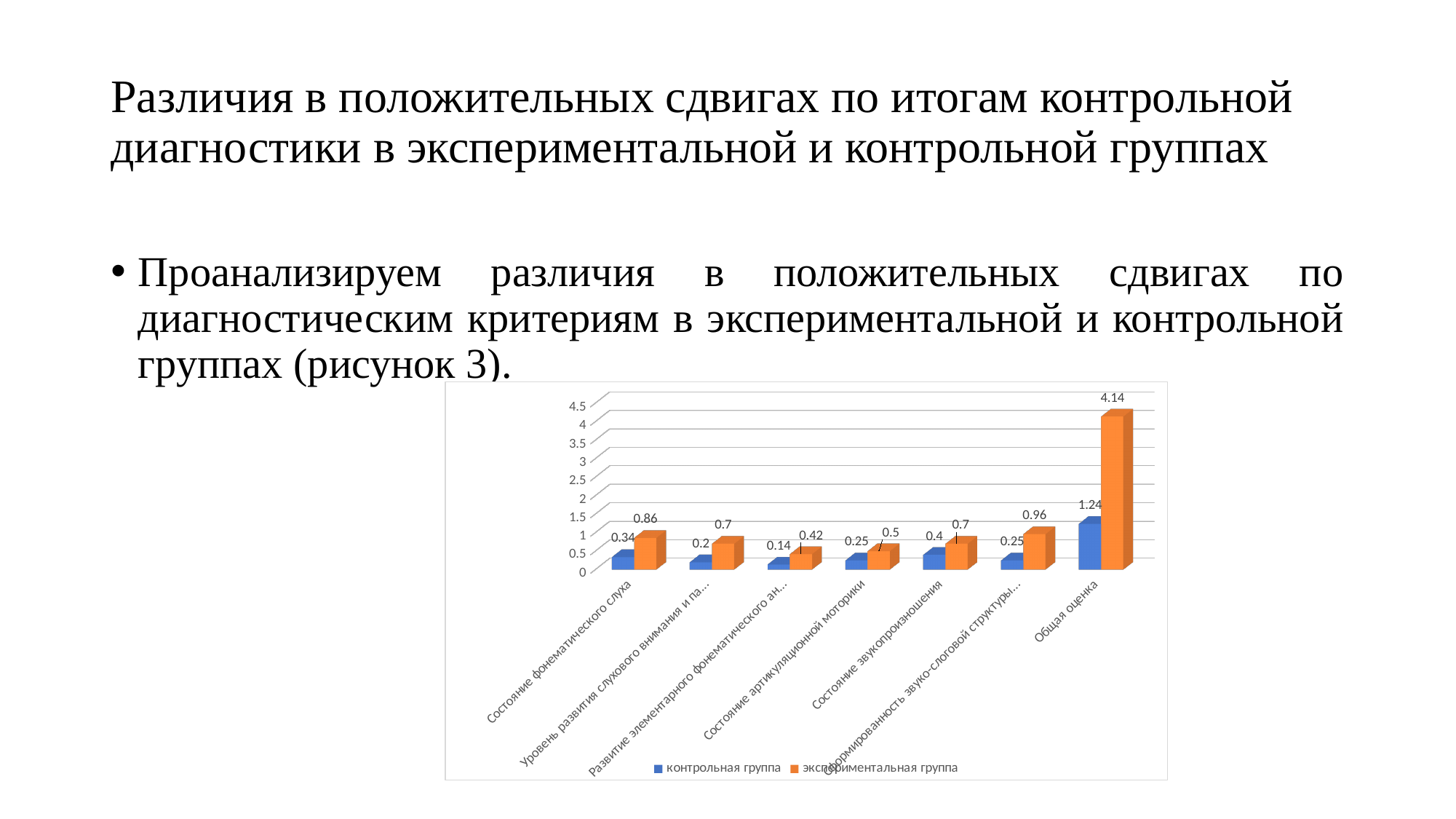
Which category has the highest value for the экспериментальная группа series? Общая оценка What is the value for the контрольная группа series for Состояние фонематического слуха? 0.34 How many categories are shown on the x axis of the chart? 7 How many series does the chart legend list? 2 Which category has the lowest value for the контрольная группа series? Развитие элементарного фонематического ан... What is the value for the экспериментальная группа series for Общая оценка? 4.14 What kind of chart is shown on the slide? bar chart For Состояние фонематического слуха, which series has the larger value: контрольная группа or экспериментальная группа? экспериментальная группа What is the value for the экспериментальная группа series for Состояние артикуляционной моторики? 0.5 What is the difference between the экспериментальная группа and контрольная группа values for Общая оценка? 2.9 What is the value for the контрольная группа series for Состояние звукопроизношения? 0.4 What is the value for the контрольная группа series for Общая оценка? 1.24